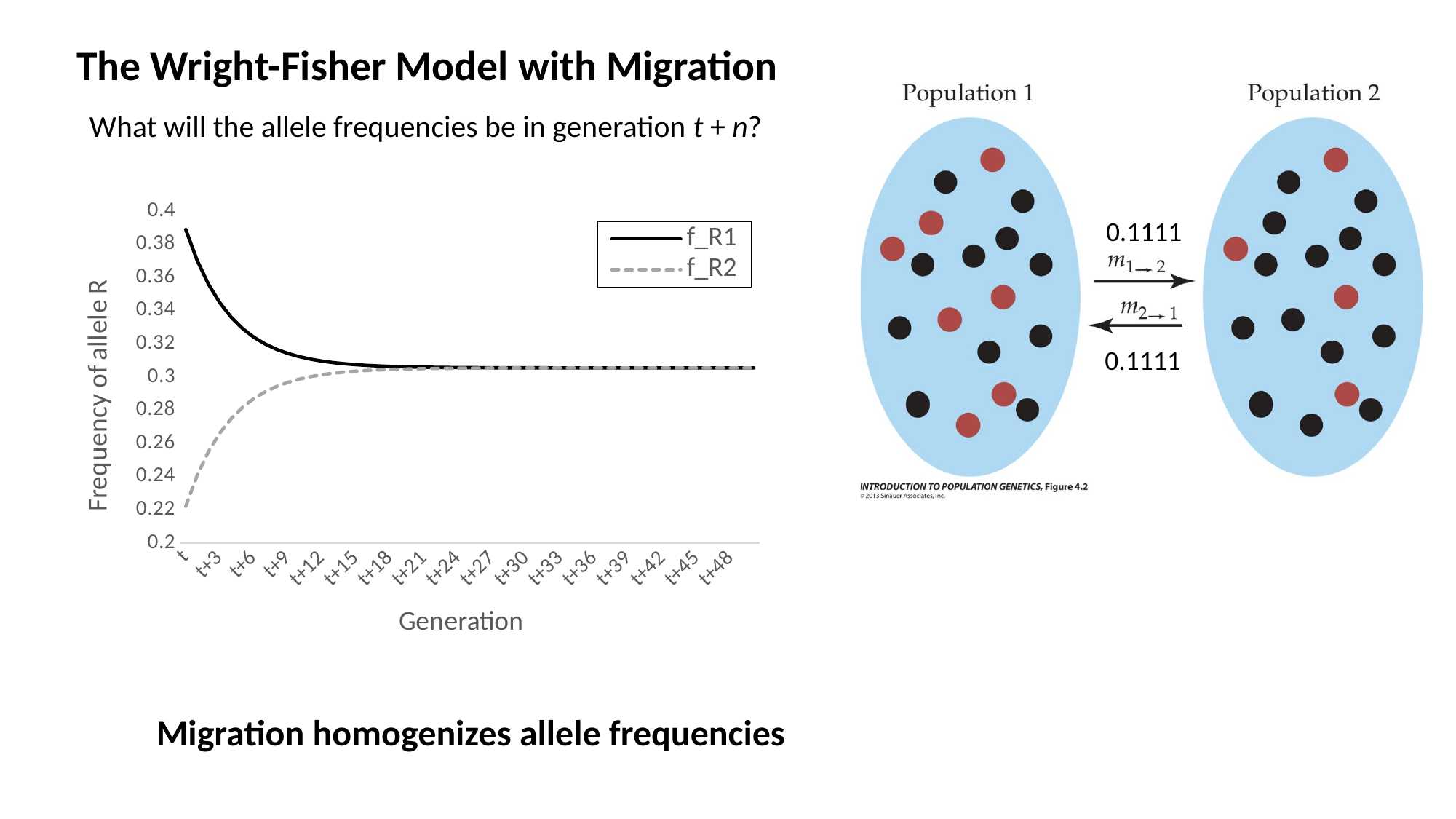
Is the value of f_R1 at generation t greater or less than 0.36? greater Is the value of f_R1 at generation t+48 greater or less than 0.32? less What are the two series named in the chart's legend? f_R1 and f_R2 Does the value of f_R2 rise or fall as generation increases along the x axis? rise At generation t, which series has the larger value, f_R1 or f_R2? f_R1 What kind of chart is shown on the slide? line chart Is the value of f_R2 at generation t+3 greater or less than 0.3? less How many series does the chart's legend list? 2 Which series in the chart is drawn with a dashed line? f_R2 Does the value of f_R1 rise or fall as generation increases along the x axis? fall